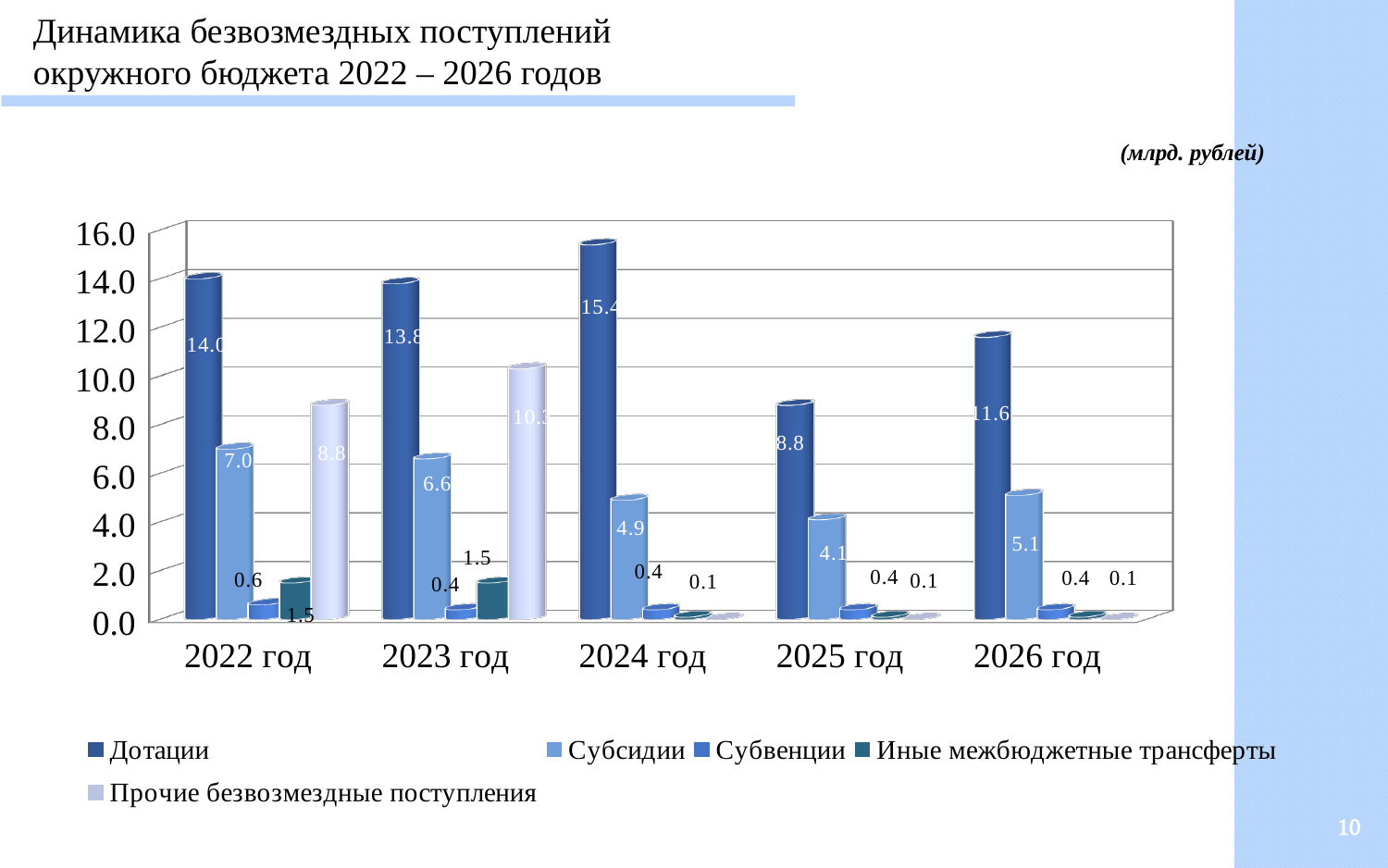
What kind of chart is shown on the slide? bar chart What is the value for Субсидии in 2022 год? 7.0 What is the difference between the Дотации values for 2024 год and 2025 год? 6.6 What is the value for Дотации in 2024 год? 15.4 How many years are shown on the x axis? 5 In which year is the value for Дотации the lowest? 2025 год Do the values for Субсидии rise or fall from 2022 год to 2025 год? fall What is the value for Прочие безвозмездные поступления in 2022 год? 8.8 Is the value for Прочие безвозмездные поступления in 2023 год greater or less than 8.0? greater In which year is the value for Дотации the highest? 2024 год How many series does the legend list? 5 Which year has the larger value for Субсидии, 2023 год or 2026 год? 2023 год